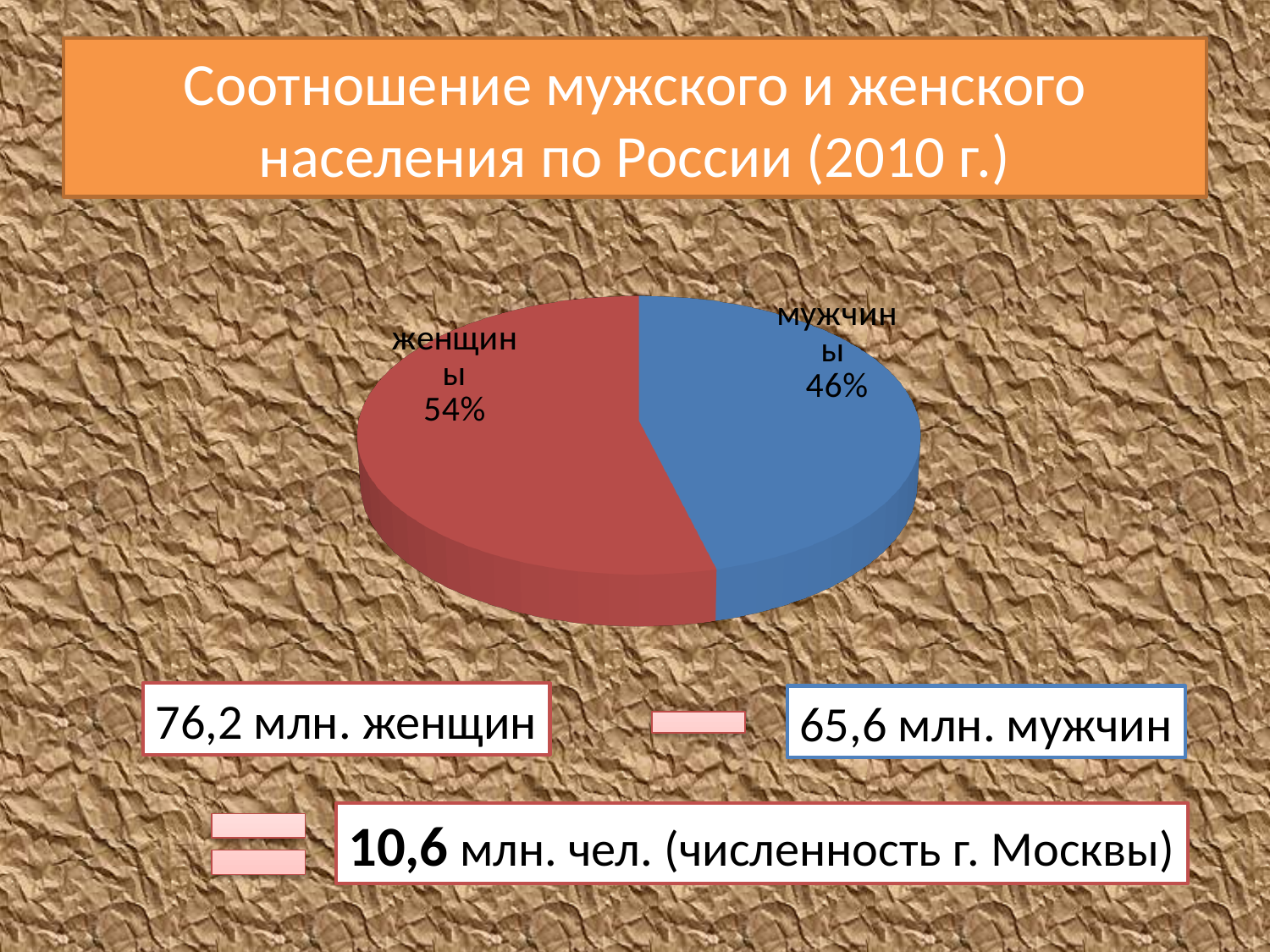
What kind of chart is shown on the slide? pie chart Which slice of the pie chart is the smallest? мужчины What colour is the slice for мужчины in the pie chart? blue What is the difference in percentage points between the женщины slice and the мужчины slice? 8 What is the title of the chart on the slide? Соотношение мужского и женского населения по России (2010 г.) Which slice of the pie chart is the largest? женщины How many slices does the pie chart have? 2 Which slice is larger, женщины or мужчины? женщины What is the total of the two slices shown in the pie chart? 100% What share of the pie does the slice for женщины represent? 54% Is the share for мужчины greater or less than 50%? less What share of the pie does the slice for мужчины represent? 46%